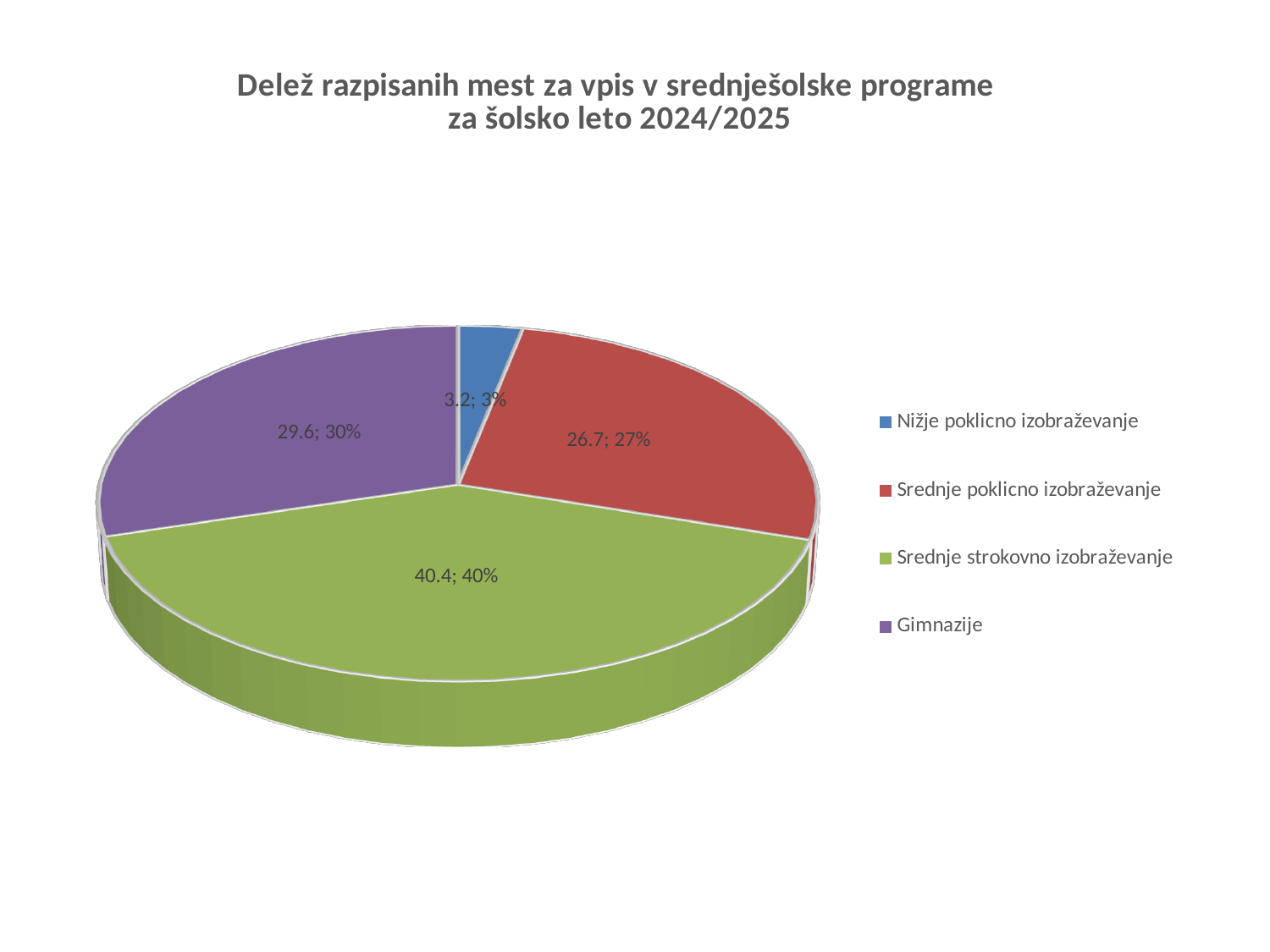
Which category has the smallest slice of the pie? Nižje poklicno izobraževanje What is the value shown for Srednje strokovno izobraževanje? 40.4 What is the difference between the values for Srednje strokovno izobraževanje and Gimnazije? 10.8 Which is larger, the value for Gimnazije or the value for Srednje poklicno izobraževanje? Gimnazije What is the value shown for Srednje poklicno izobraževanje? 26.7 What percentage share of the pie does Gimnazije have? 30% What kind of chart is shown on the slide? Pie chart What is the value shown for Gimnazije? 29.6 Which category has the largest slice of the pie? Srednje strokovno izobraževanje What is the value shown for Nižje poklicno izobraževanje? 3.2 What percentage share of the pie does Srednje poklicno izobraževanje have? 27% How many categories does the legend list? 4